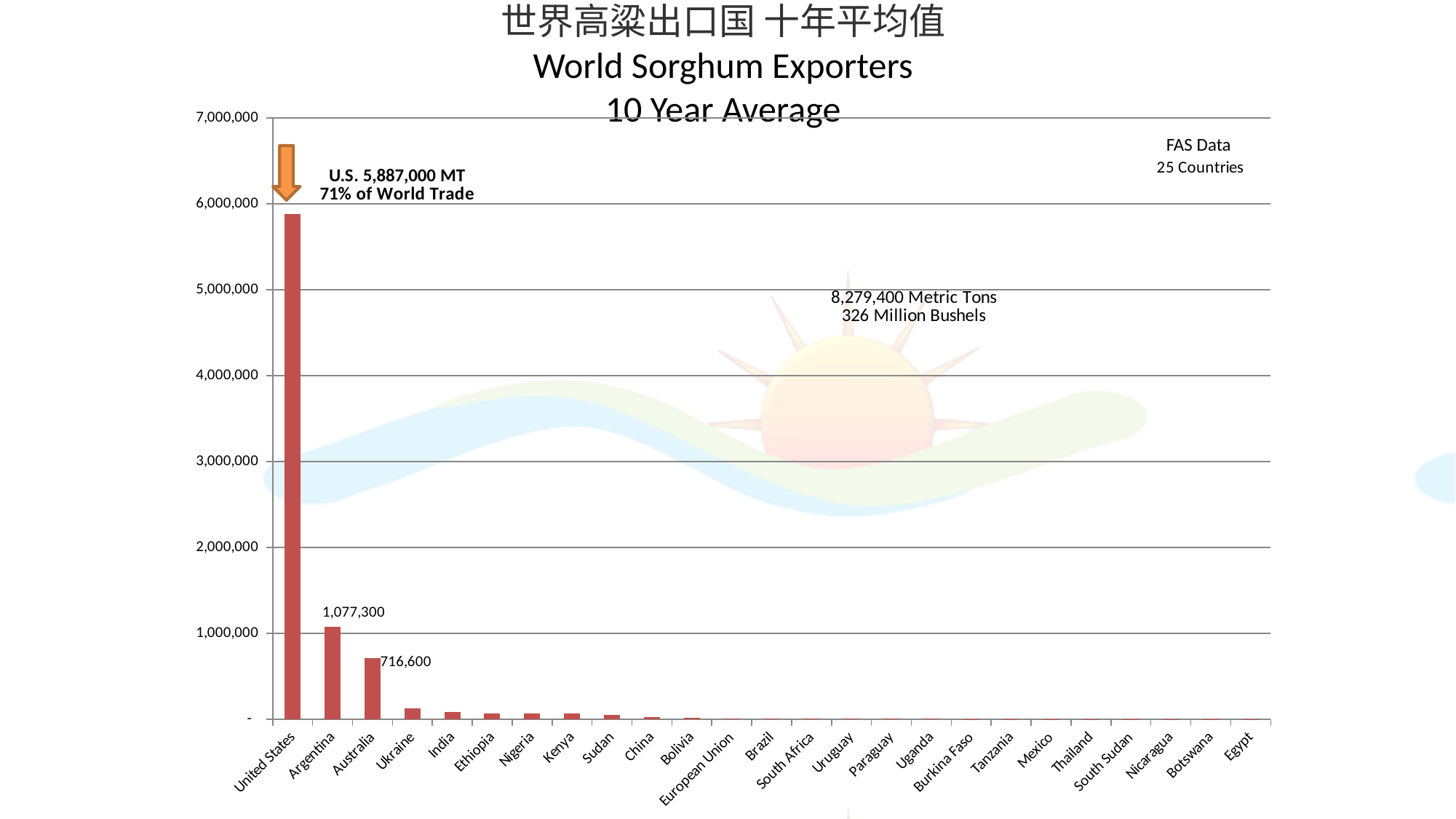
Is the value for United States greater or less than 5,000,000? greater What kind of chart is shown on the slide? bar chart What is the U.S. 10-year average sorghum export value as annotated on the chart? 5,887,000 MT According to the annotation on the chart, what share of world sorghum trade does the U.S. account for? 71% How many countries are shown on the x axis of the chart? 25 What is the 10-year average sorghum export value for Australia? 716,600 Which country has the highest 10-year average sorghum exports? United States Is the value for Ukraine greater or less than 1,000,000? less What is the data source named on the chart? FAS Data What is the 10-year average sorghum export value for Argentina? 1,077,300 What is the difference between Argentina's and Australia's 10-year average sorghum exports? 360,700 Which has larger 10-year average sorghum exports, Argentina or Australia? Argentina